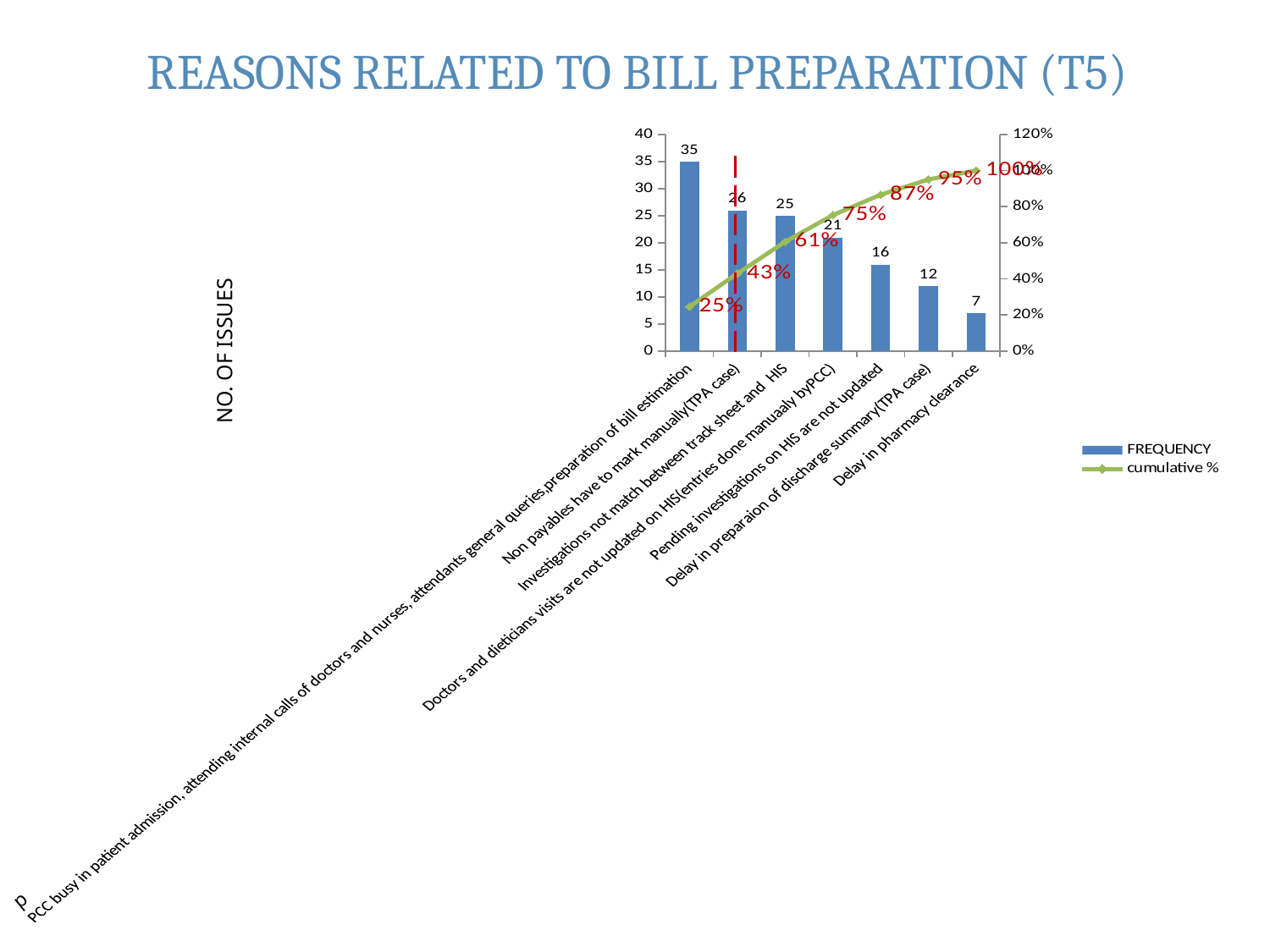
What is the cumulative % value at "Investigations not match between track sheet and HIS"? 61% How many series does the legend list? 2 Which category has the lowest FREQUENCY? Delay in pharmacy clearance Which has a higher FREQUENCY: "Investigations not match between track sheet and HIS" or "Doctors and dieticians visits are not updated on HIS(entries done manuaaly byPCC)"? Investigations not match between track sheet and HIS What is the title of the slide containing the chart? REASONS RELATED TO BILL PREPARATION (T5) What is the FREQUENCY value for "Delay in pharmacy clearance"? 7 How many categories are shown on the x axis of the chart? 7 Which category has the highest FREQUENCY? PCC busy in patient admission, attending internal calls of doctors and nurses, attendants general queries,preparation of bill estimation What is the cumulative % value at "Pending investigations on HIS are not updated"? 87% What is the FREQUENCY value for "Non payables have to mark manually(TPA case)"? 26 Do the FREQUENCY values rise or fall from left to right along the x axis? fall What is the difference in FREQUENCY between "Pending investigations on HIS are not updated" and "Delay in preparaion of discharge summary(TPA case)"? 4